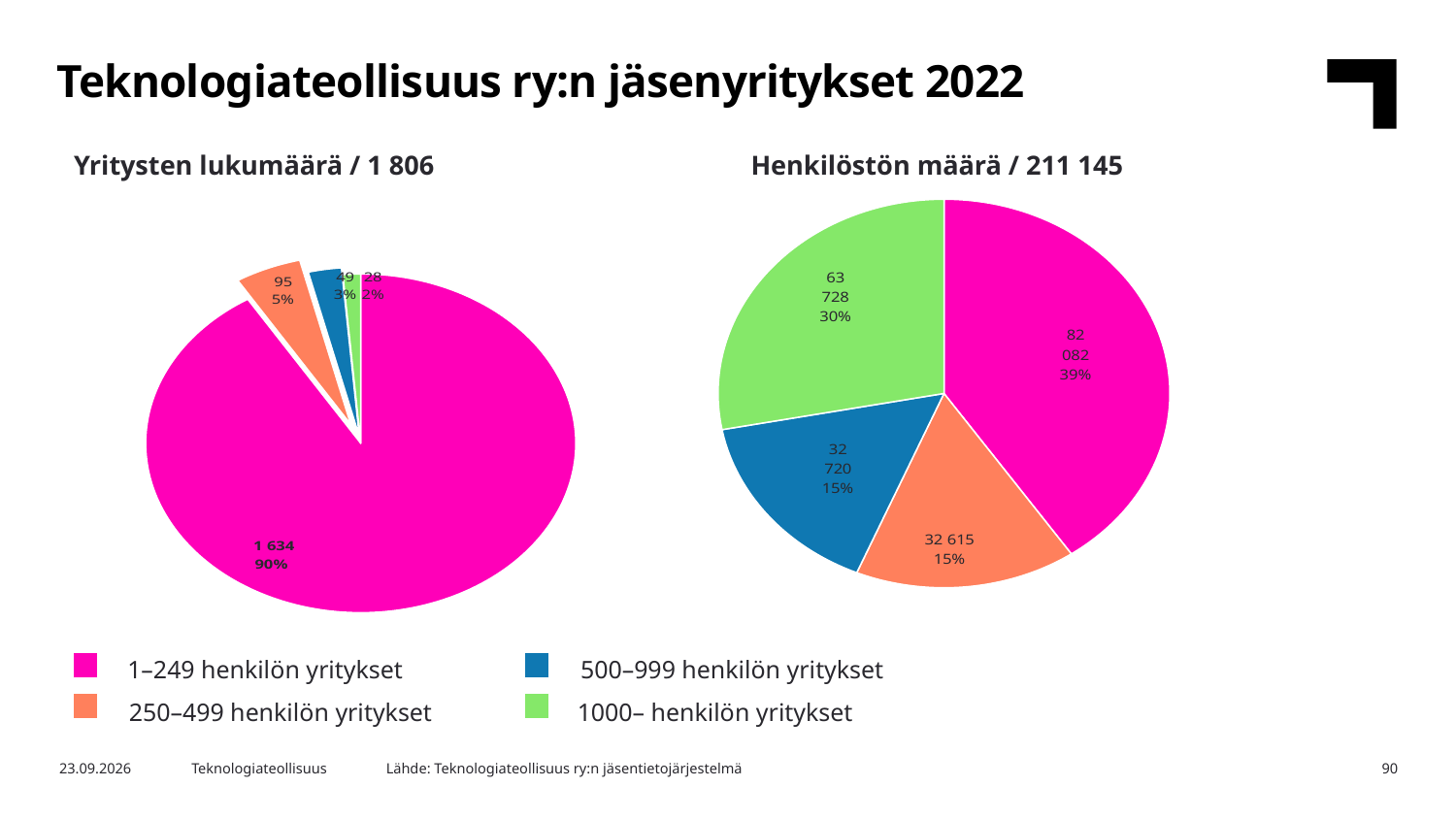
In the 'Henkilöstön määrä / 211 145' chart, which is larger: the value for 1000– henkilön yritykset or the value for 500–999 henkilön yritykset? 1000– henkilön yritykset In the 'Henkilöstön määrä / 211 145' chart, what is the value for 1000– henkilön yritykset? 63 728 In the 'Henkilöstön määrä / 211 145' chart, what is the difference between the values for 1–249 henkilön yritykset and 1000– henkilön yritykset? 18 354 In the 'Henkilöstön määrä / 211 145' chart, what share of the pie is 1–249 henkilön yritykset? 39% In the 'Yritysten lukumäärä / 1 806' chart, what is the value for 1–249 henkilön yritykset? 1 634 In the 'Yritysten lukumäärä / 1 806' chart, what is the difference between the values for 250–499 henkilön yritykset and 500–999 henkilön yritykset? 46 In the 'Yritysten lukumäärä / 1 806' chart, which category has the smallest slice? 1000– henkilön yritykset How many slices does the 'Henkilöstön määrä / 211 145' chart have? 4 In the 'Yritysten lukumäärä / 1 806' chart, what share of the pie is 250–499 henkilön yritykset? 5% How many entries does the legend list? 4 What kind of chart is the 'Yritysten lukumäärä / 1 806' chart? pie chart In the 'Henkilöstön määrä / 211 145' chart, which category has the largest slice? 1–249 henkilön yritykset